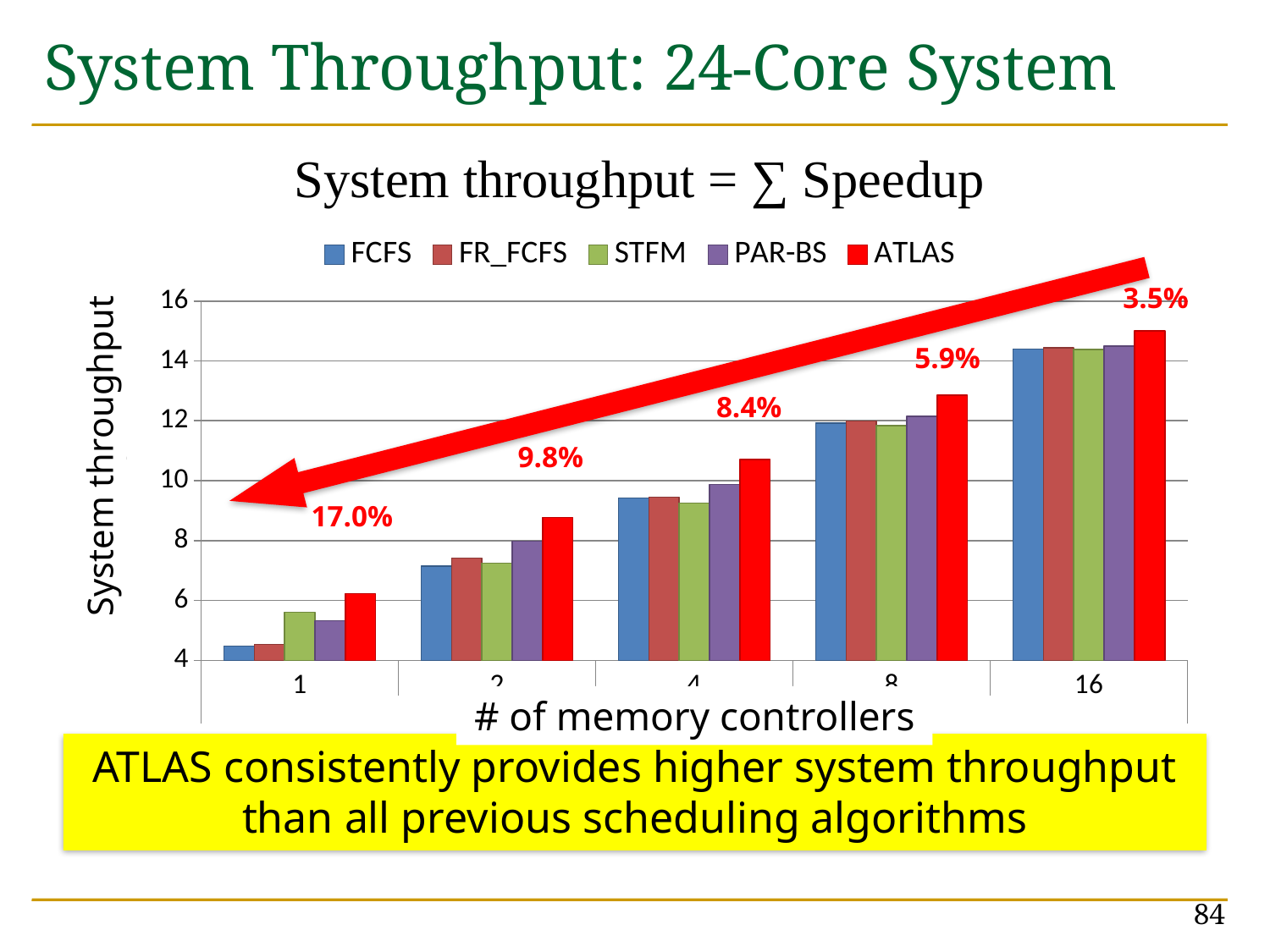
Which scheduling algorithm has the highest system throughput with 16 memory controllers? ATLAS Is the system throughput for ATLAS with 1 memory controller greater or less than 8? less With 16 memory controllers, which has the higher system throughput, FCFS or ATLAS? ATLAS Is the system throughput for ATLAS with 16 memory controllers greater or less than 14? greater What percentage improvement is annotated next to the bars for 1 memory controller? 17.0% What percentage improvement is annotated above the bars for 16 memory controllers? 3.5% Is the system throughput for FCFS with 1 memory controller greater or less than 6? less How many series does the legend list? 5 How many groups of bars (memory controller counts) are plotted along the x axis? 5 What kind of chart is shown on the slide? bar chart Does the system throughput for ATLAS rise or fall as the number of memory controllers increases? rise